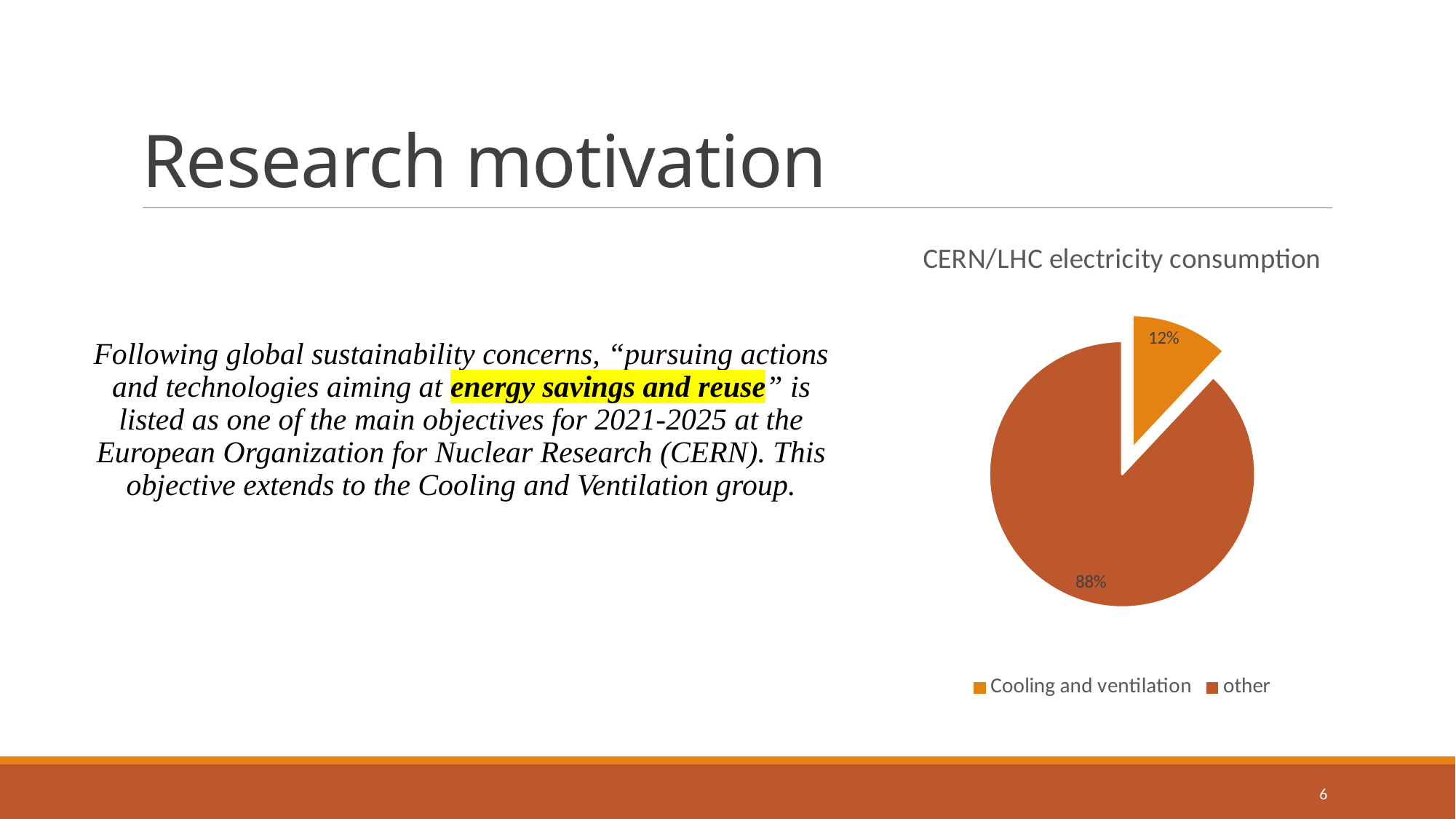
Which is larger, the share for Cooling and ventilation or the share for other? other Which category has the smallest share of the pie? Cooling and ventilation How many slices does the pie chart have? 2 What share of CERN/LHC electricity consumption is attributed to Cooling and ventilation? 12% What share of CERN/LHC electricity consumption is attributed to other? 88% What is the difference in percentage points between the other slice and the Cooling and ventilation slice? 76 What kind of chart is shown on the slide? pie chart How many entries does the legend list? 2 What is the title of the chart? CERN/LHC electricity consumption Which slice is pulled out (exploded) from the pie? Cooling and ventilation Which category has the largest share of the pie? other